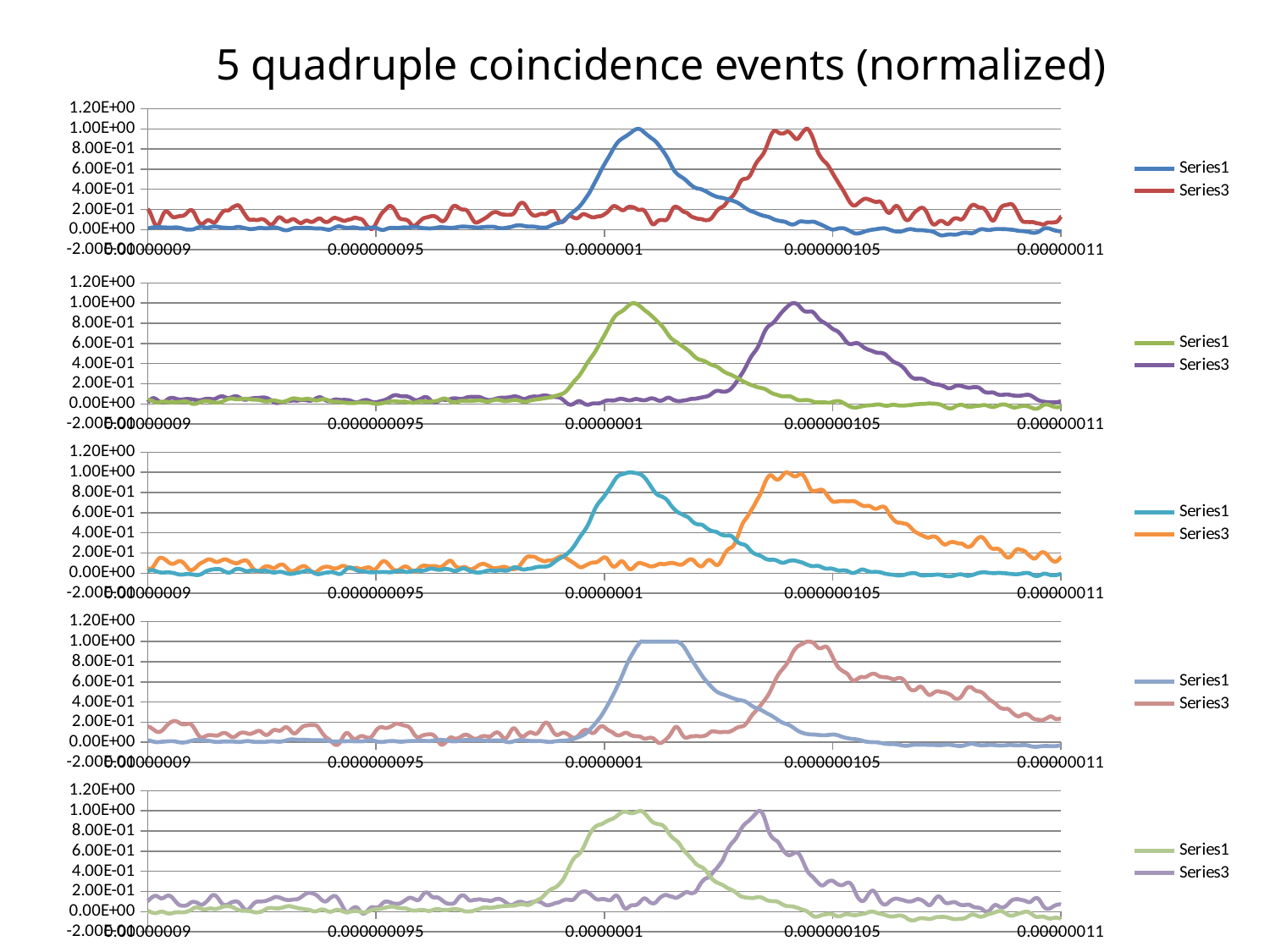
What is the title of the slide's charts? 5 quadruple coincidence events (normalized) What are the legend entries of the bottom chart? Series1, Series3 How many series does the legend of the top chart list? 2 In the fourth chart from the top, which series reaches its peak at a smaller x value, Series1 or Series3? Series1 What is the highest value shown on the vertical axis of each chart? 1.20E+00 What kind of chart is used on this slide? line chart In the second chart from the top, is the value of Series1 at x = 0.000000105 greater or less than 4.00E-01? less In the top chart, is the peak value of Series1 greater or less than 6.00E-01? greater In the bottom chart, at x = 0.000000105, which series has the larger value, Series1 or Series3? Series3 In the third chart from the top, is the peak value of Series3 greater or less than 8.00E-01? greater How many charts are shown on the slide? 5